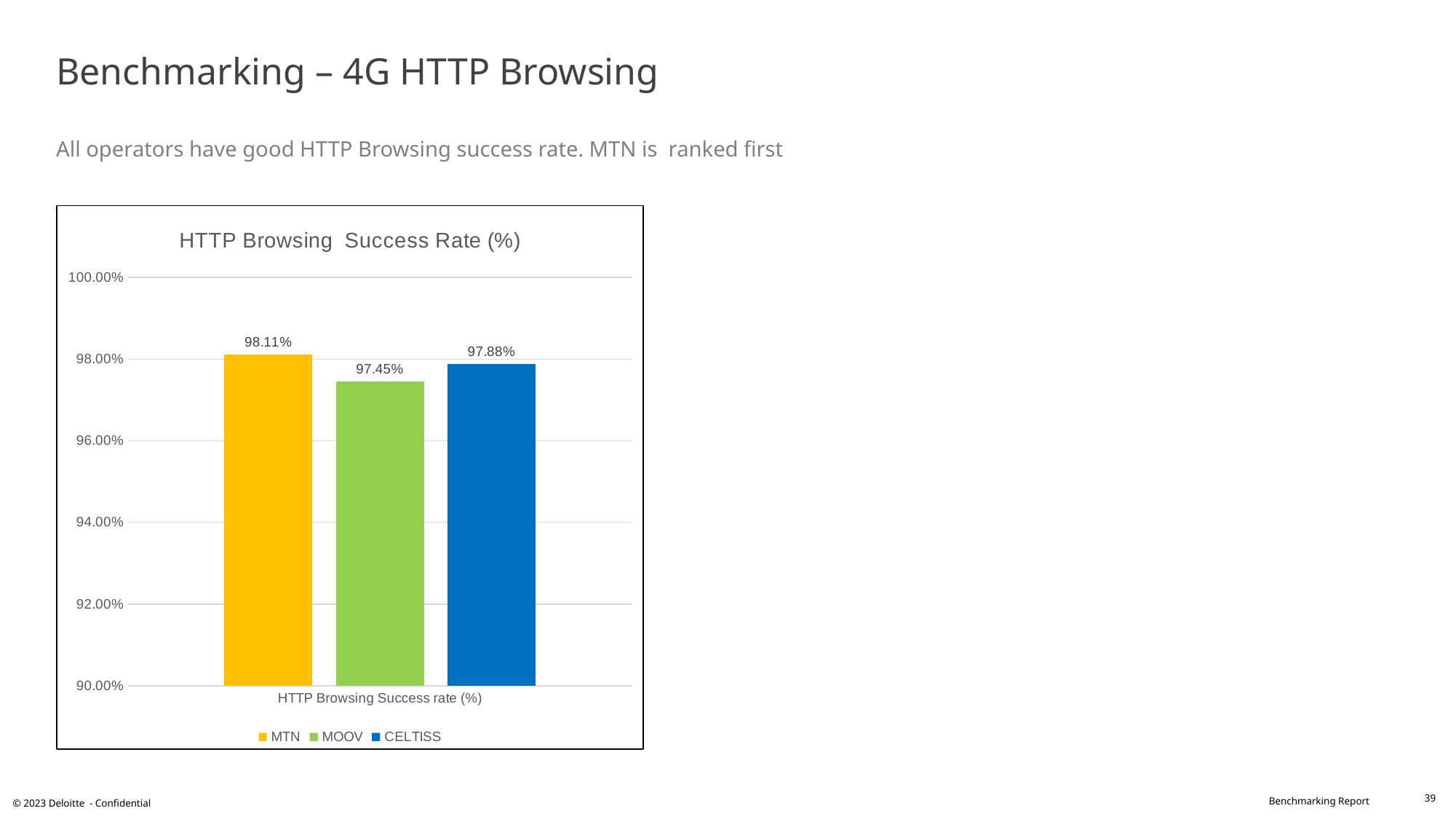
How many series does the legend list? 3 What kind of chart is shown on the slide? Bar chart What is the difference between MTN's and MOOV's HTTP Browsing success rates? 0.66% What is the difference between CELTISS's and MOOV's HTTP Browsing success rates? 0.43% What is the HTTP Browsing success rate for MOOV? 97.45% What is the title of the chart? HTTP Browsing Success Rate (%) Which has a higher HTTP Browsing success rate, CELTISS or MOOV? CELTISS What is the HTTP Browsing success rate for CELTISS? 97.88% What is the HTTP Browsing success rate for MTN? 98.11% Is the value for MOOV greater or less than 98.00%? less Which operator has the lowest HTTP Browsing success rate? MOOV Which operator has the highest HTTP Browsing success rate? MTN